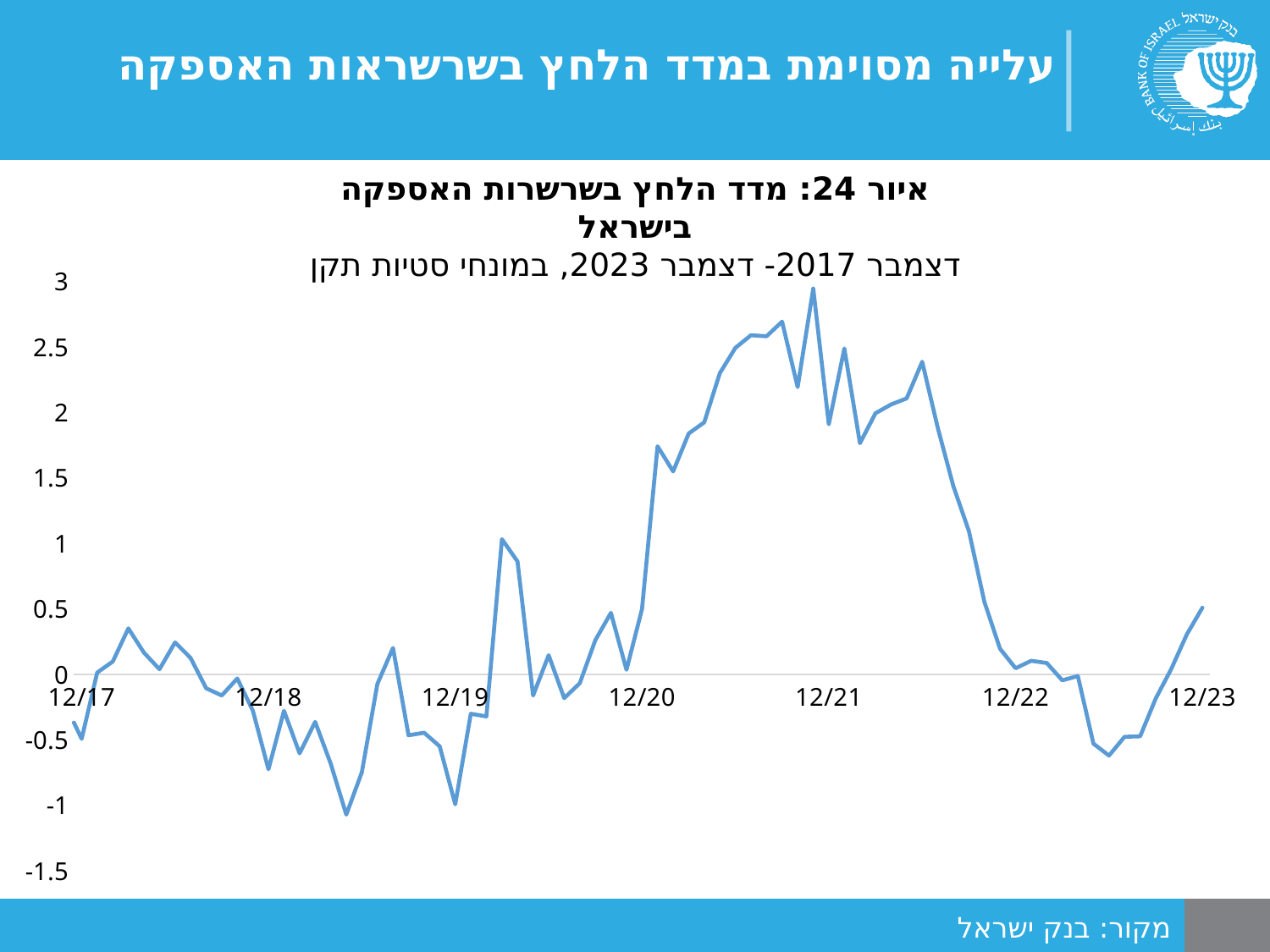
Around which x-axis date label does the line reach its highest value? 12/21 How many date labels are shown on the x axis of the chart? 7 Is the value of the index at 12/17 greater or less than 0? less Which is larger, the value at 12/21 or the value at 12/22? 12/21 What kind of chart is shown on the slide? line chart Is the value of the index at 12/22 greater or less than 0.5? less Does the line rise or fall between 12/19 and 12/20? rise How many data series are plotted in the chart? 1 What is the highest value shown on the y axis? 3 What is the figure number given in the chart title? 24 Does the line rise or fall between 12/21 and 12/22? fall